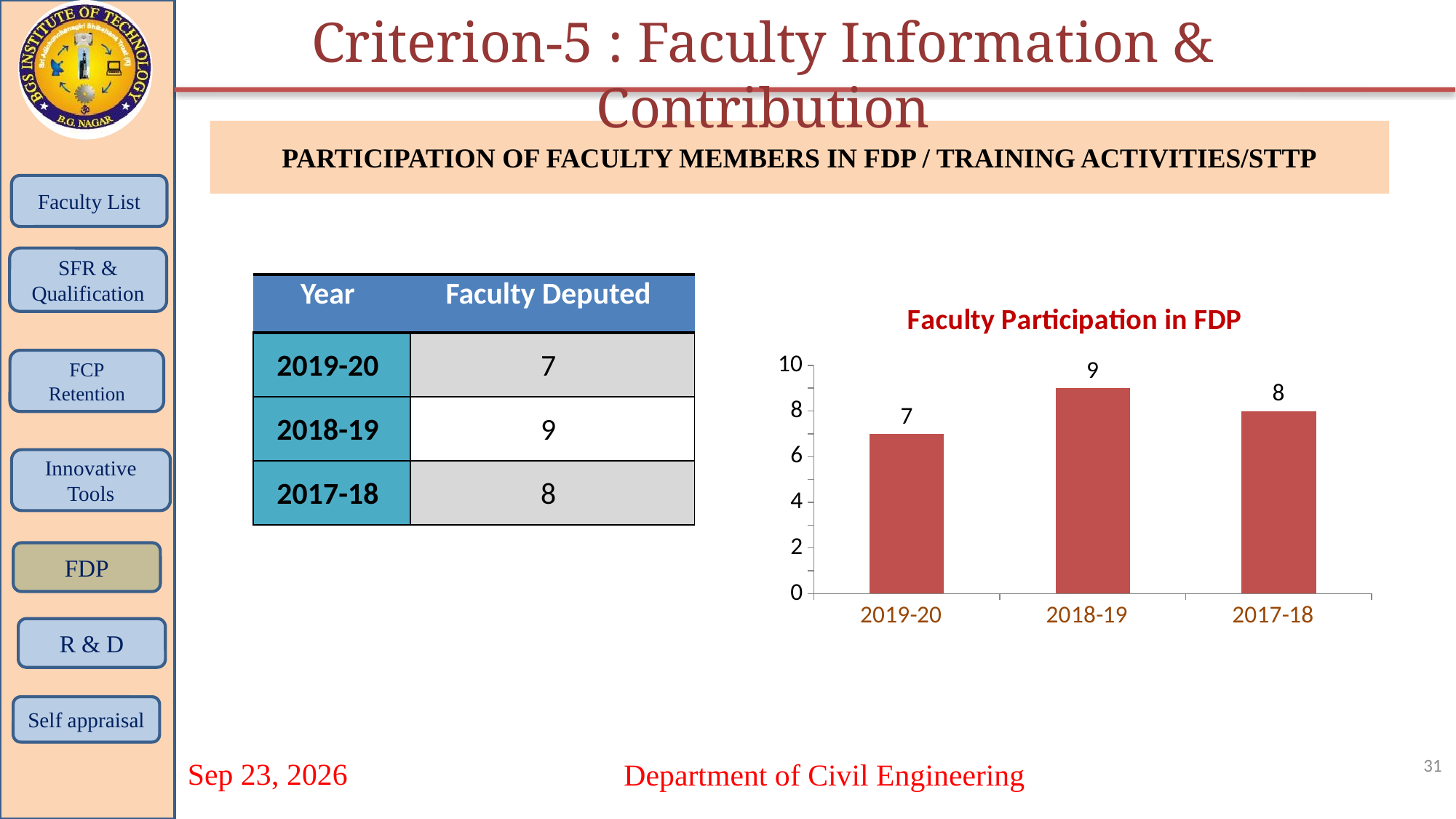
What kind of chart is the Faculty Participation in FDP chart? bar chart What is the value for 2018-19 in the Faculty Participation in FDP chart? 9 What is the value for 2017-18 in the Faculty Participation in FDP chart? 8 What is the value for 2019-20 in the Faculty Participation in FDP chart? 7 Is the value for 2018-19 in the Faculty Participation in FDP chart greater or less than 8? greater Which year has the highest value in the Faculty Participation in FDP chart? 2018-19 How many years are shown in the Faculty Participation in FDP chart? 3 What is the maximum value shown on the vertical axis of the Faculty Participation in FDP chart? 10 What is the difference between the values for 2018-19 and 2019-20 in the Faculty Participation in FDP chart? 2 In the Faculty Participation in FDP chart, which is larger: the value for 2017-18 or the value for 2019-20? 2017-18 What is the title of the chart on the slide? Faculty Participation in FDP Which year has the lowest value in the Faculty Participation in FDP chart? 2019-20